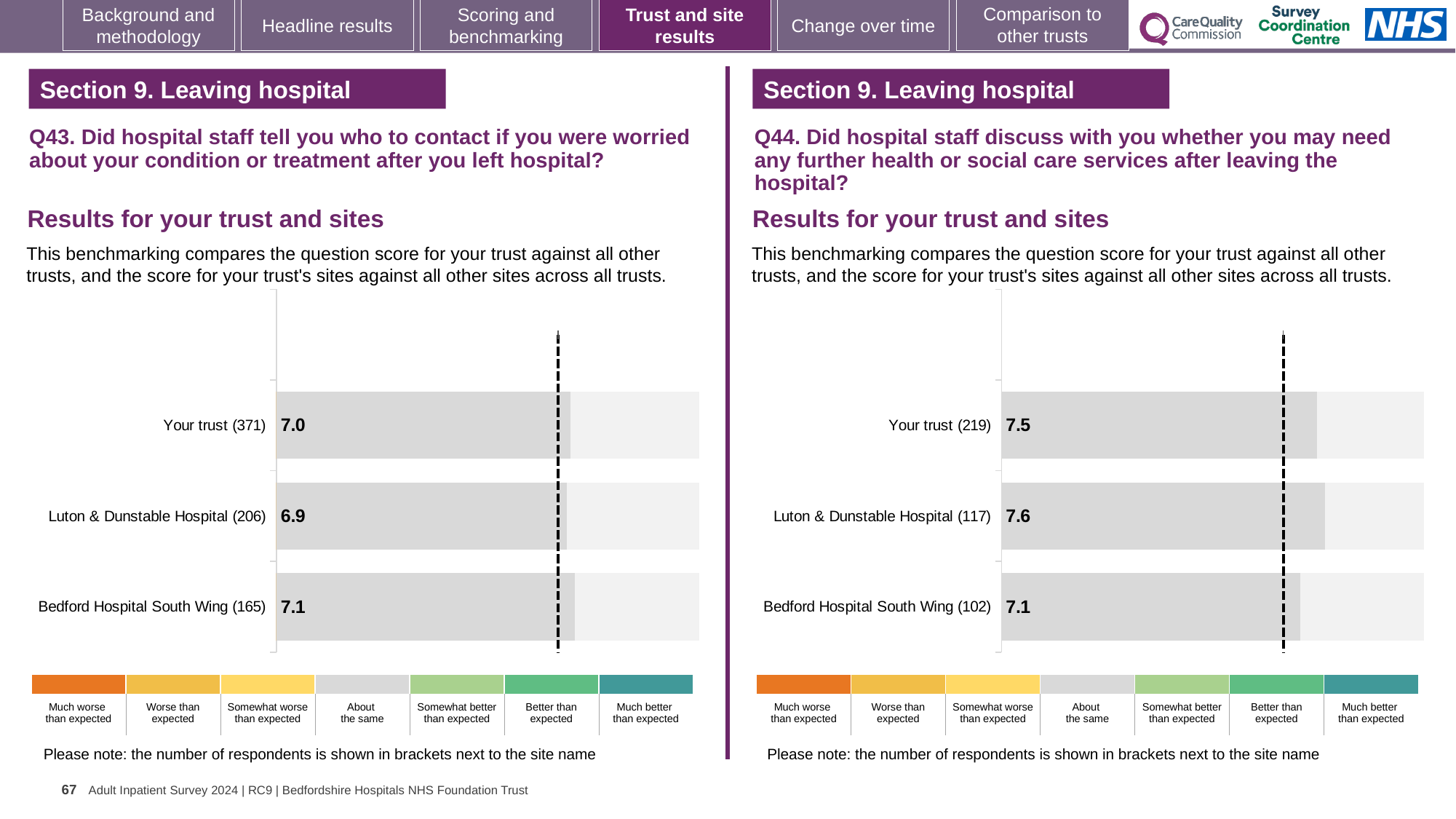
In the Q44 chart on the right, what is the difference between the scores for Luton & Dunstable Hospital and Bedford Hospital South Wing? 0.5 In the Q44 chart on the right, what is the score for Your trust? 7.5 In the Q44 chart on the right, how many bars are plotted? 3 In the Q43 chart on the left, which site or trust has the lowest score? Luton & Dunstable Hospital In the Q43 chart on the left, which site or trust has the highest score? Bedford Hospital South Wing In the Q43 chart on the left, what is the score for Luton & Dunstable Hospital? 6.9 In the Q43 chart on the left, what is the score for Your trust? 7.0 In the Q44 chart on the right, what is the score for Bedford Hospital South Wing? 7.1 In the Q44 chart on the right, which site or trust has the highest score? Luton & Dunstable Hospital What type of chart is used in the Q43 chart on the left? Bar chart In the Q43 chart on the left, how many respondents are shown in brackets for Your trust? 371 In the Q43 chart on the left, what is the difference between the scores for Bedford Hospital South Wing and Luton & Dunstable Hospital? 0.2